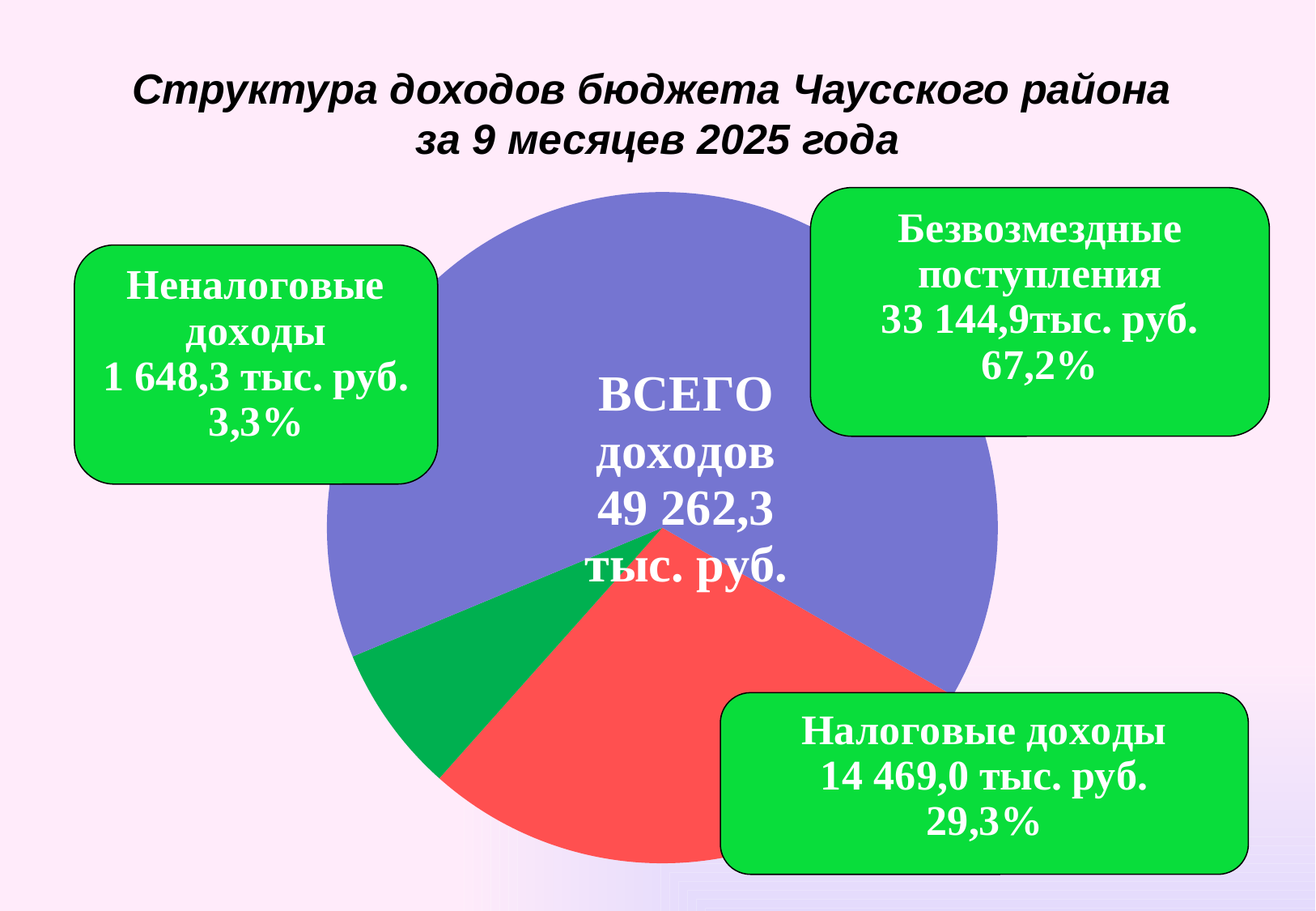
What share of the pie is Неналоговые доходы? 3,3% What is the value of Налоговые доходы? 14 469,0 тыс. руб. How many slices does the pie chart have? 3 What is the difference between Безвозмездные поступления and Налоговые доходы in тыс. руб.? 18 675,9 тыс. руб. What share of the pie is Безвозмездные поступления? 67,2% What is the value of Неналоговые доходы? 1 648,3 тыс. руб. What is the total of all income shown in the pie chart? 49 262,3 тыс. руб. Which category has the largest slice? Безвозмездные поступления Which category has the smallest slice? Неналоговые доходы What kind of chart is shown on the slide? pie chart What is the value of Безвозмездные поступления? 33 144,9 тыс. руб. What colour is the slice for Налоговые доходы? red